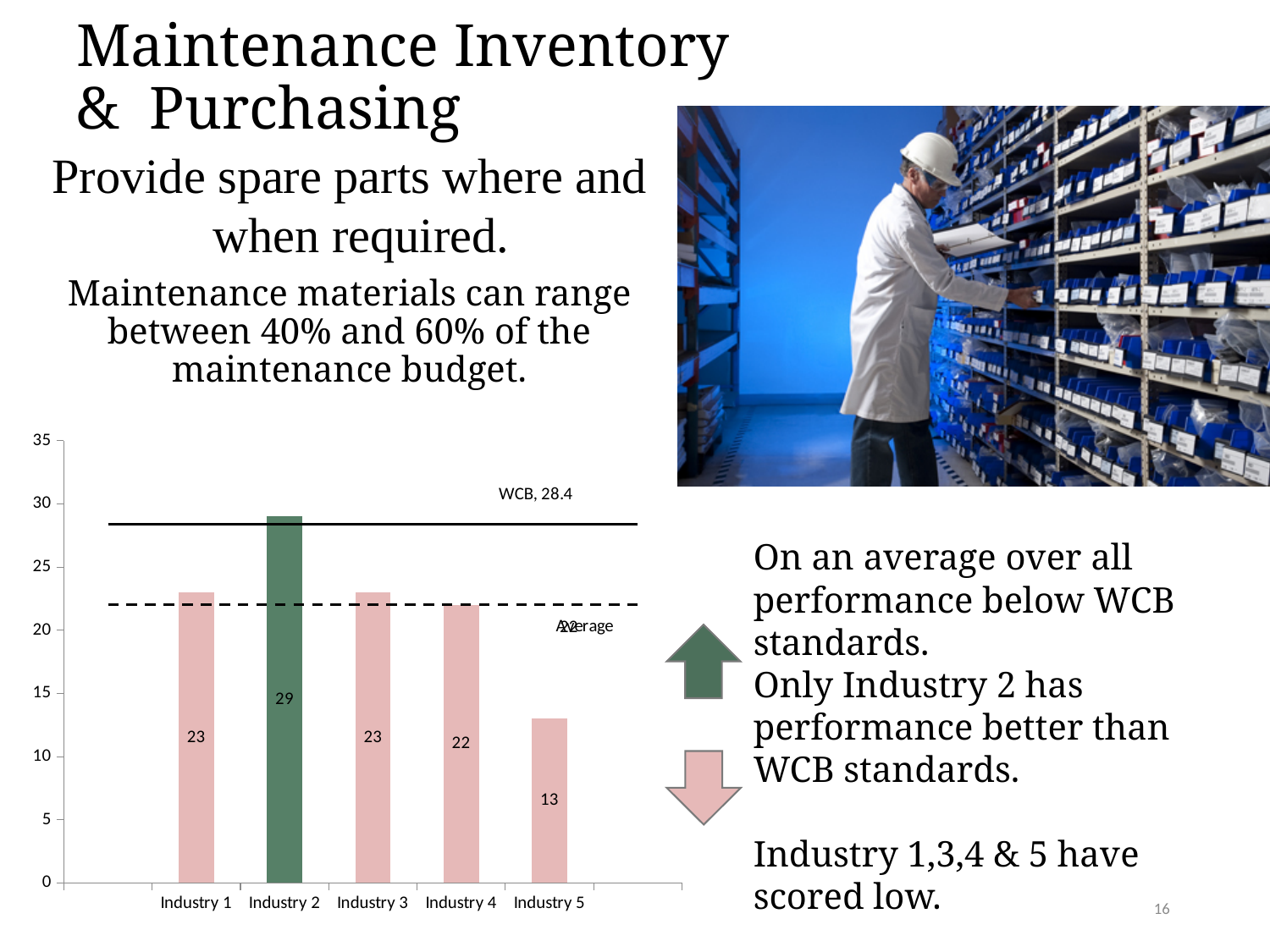
Which industry has the highest value? Industry 2 How many industries are shown on the x axis? 5 Which industry's bar is coloured green rather than pink? Industry 2 What is the value for Industry 5? 13 Which is larger, the value for Industry 1 or the value for Industry 5? Industry 1 Which industry has the lowest value? Industry 5 What is the value for Industry 4? 22 What is the value for Industry 2? 29 What is the difference between the values for Industry 2 and Industry 5? 16 What value is labelled for the WCB line on the chart? 28.4 What kind of chart is shown on the slide? Bar chart Is the value for Industry 5 greater or less than 15? less